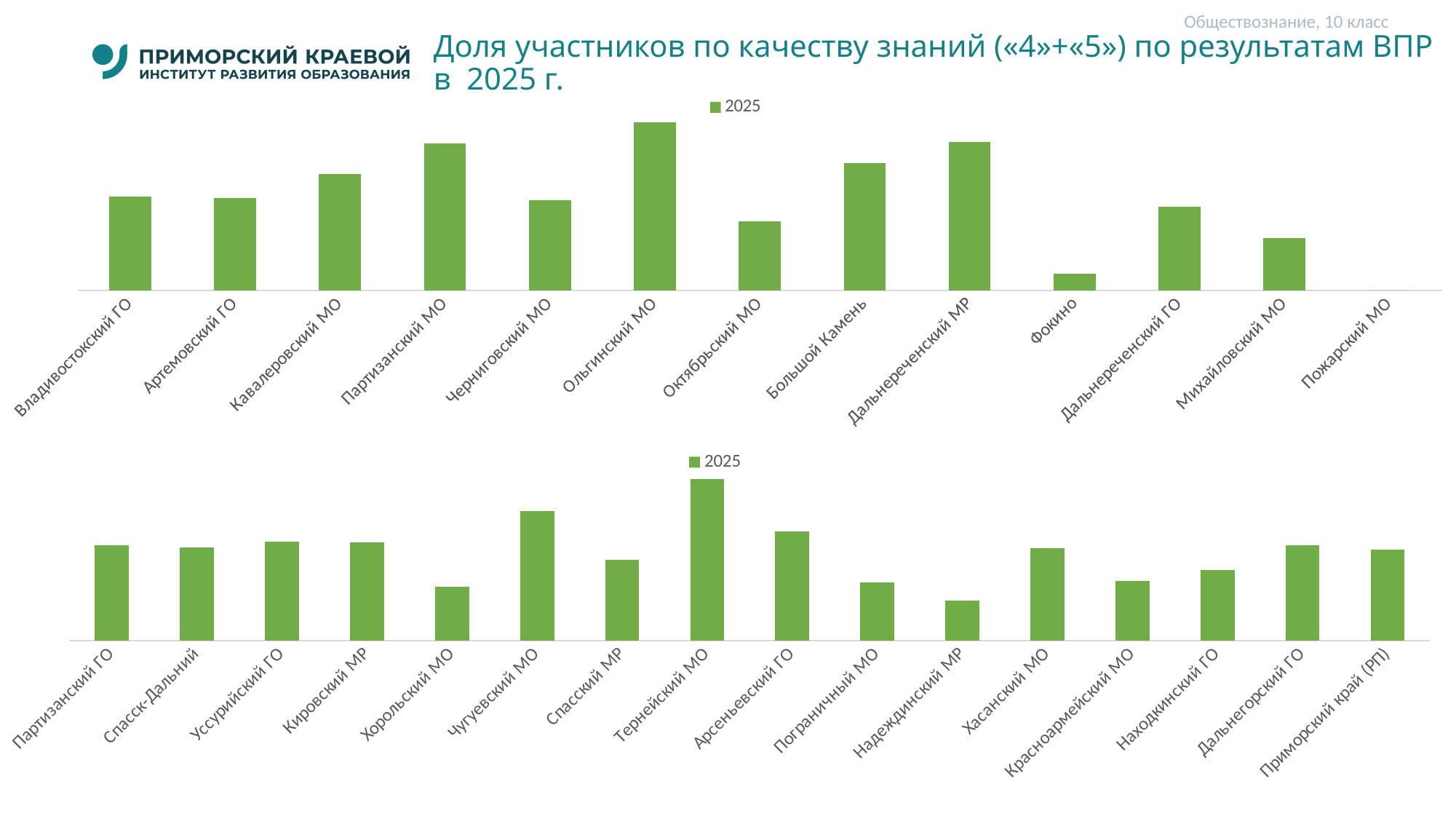
In the top chart, which is larger: the value for Фокино or the value for Михайловский МО? Михайловский МО In the bottom chart, which is larger: the value for Хорольский МО or the value for Кировский МР? Кировский МР In the top chart, which category has the highest value? Ольгинский МО How many categories are shown in the top chart? 13 What kind of chart is the bottom chart? Bar chart In the bottom chart, which is larger: the value for Чугуевский МО or the value for Арсеньевский ГО? Чугуевский МО How many categories are shown in the bottom chart? 16 How many series does the legend of the top chart list? 1 What is the legend entry shown above the bottom chart? 2025 In the bottom chart, which category has the lowest value? Надеждинский МР In the bottom chart, which category has the highest value? Тернейский МО